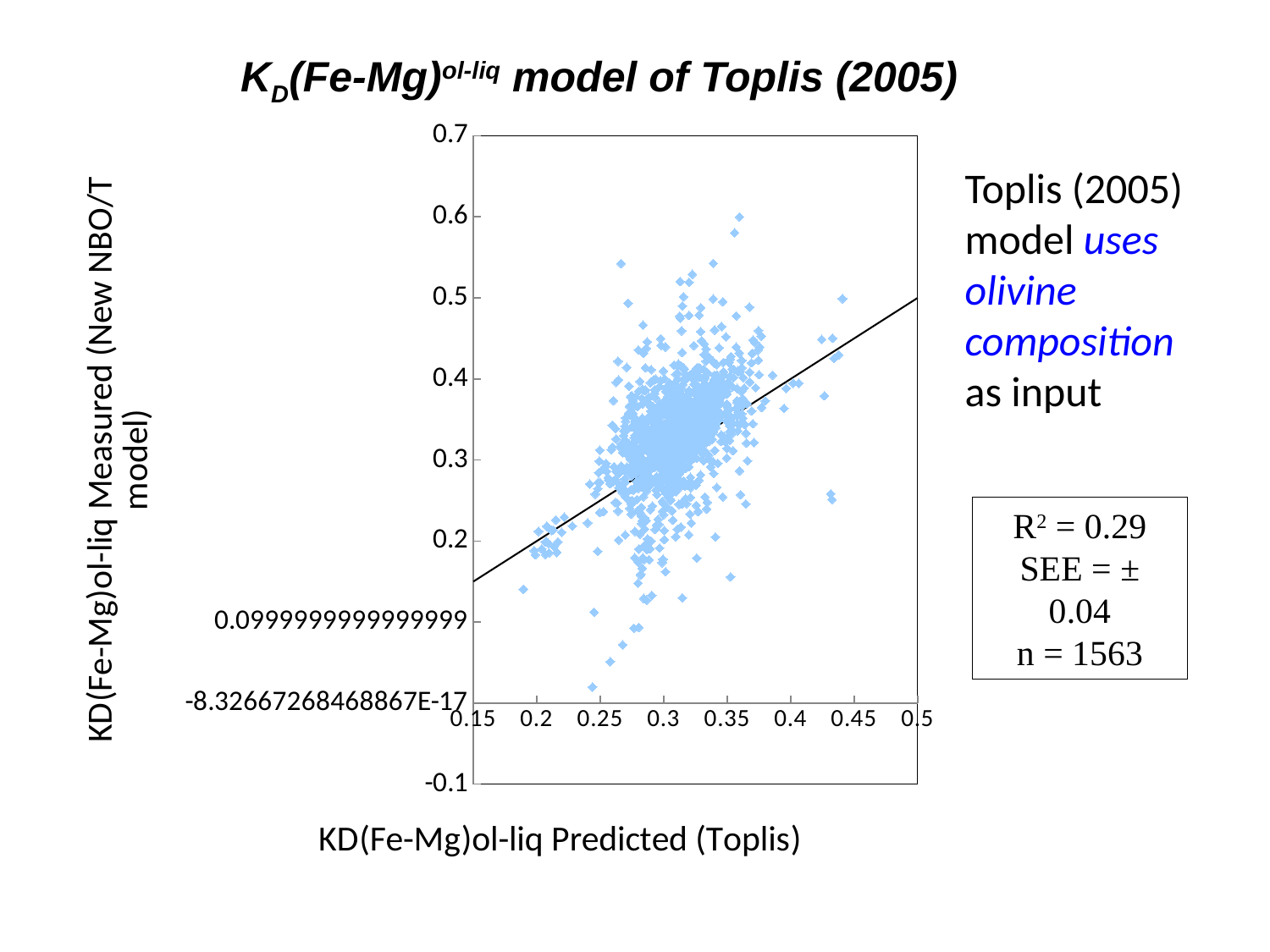
What is the highest tick value shown on the y axis? 0.7 What R² value is reported for the Toplis (2005) model fit? 0.29 Is the value of the fitted line at x = 0.15 greater or less than 0.2? less What colour are the data point markers in the scatter chart? light blue What kind of chart is shown on the slide? scatter chart How many data points (n) does the chart's annotation box report? 1563 Do the measured KD values generally rise or fall as the predicted KD values increase along the x axis? rise What is the highest tick value shown on the x axis? 0.5 Is the value of the fitted line at x = 0.5 greater or less than 0.4? greater What is the title of the x axis? KD(Fe-Mg)ol-liq Predicted (Toplis) What is the lowest tick value shown on the y axis? -0.1 What SEE value is reported in the box beside the chart? ± 0.04